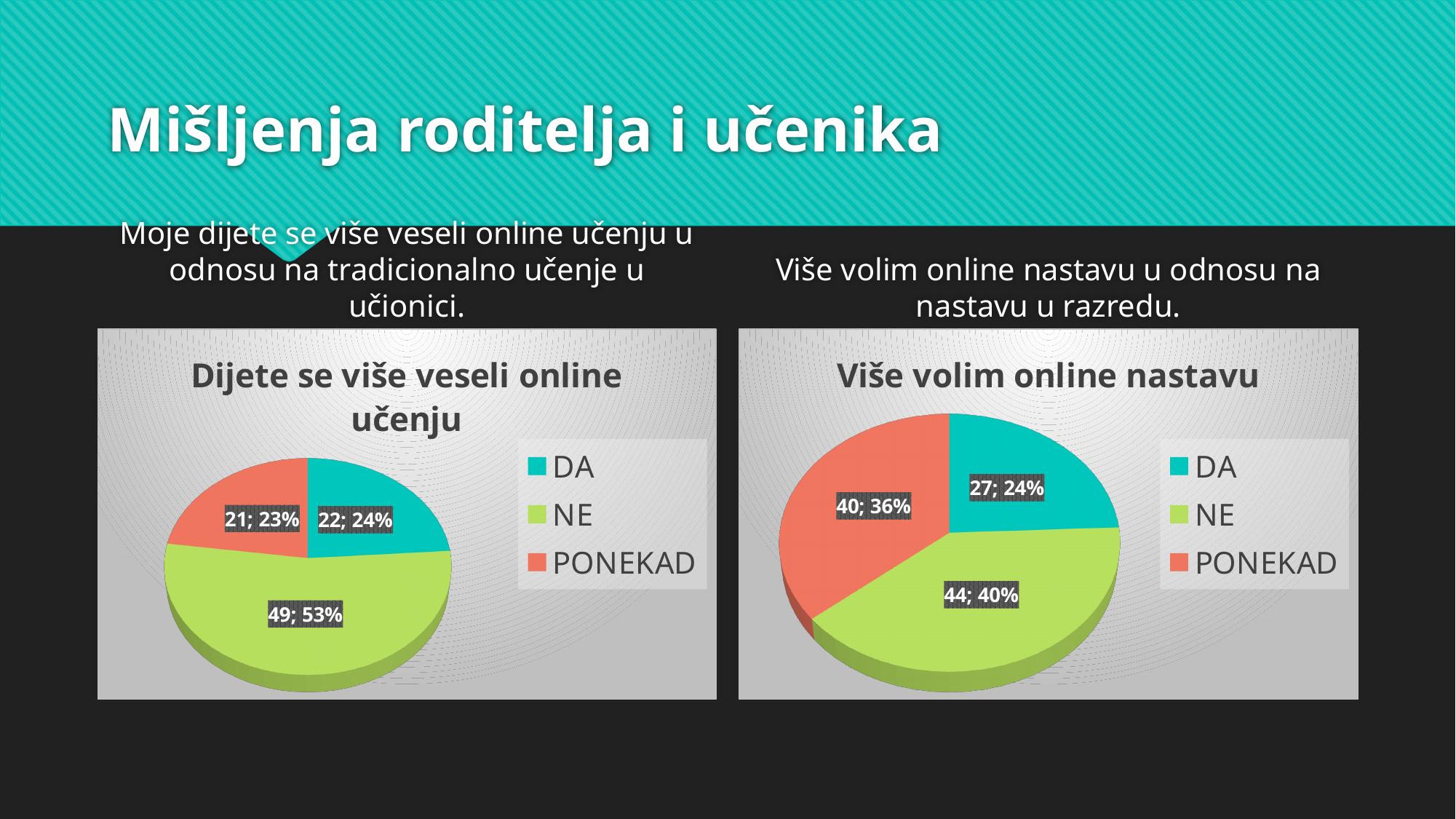
In the left chart 'Dijete se više veseli online učenju', what share of the pie does DA take? 24% In the left chart 'Dijete se više veseli online učenju', which is larger, DA or PONEKAD? DA In the right chart 'Više volim online nastavu', what share of the pie does NE take? 40% Which colour represents PONEKAD in the legend of the right chart 'Više volim online nastavu'? Red/orange In the left chart 'Dijete se više veseli online učenju', what is the total count across all slices? 92 What type of chart is the left chart 'Dijete se više veseli online učenju'? Pie chart In the right chart 'Više volim online nastavu', what is the difference between the counts for NE and DA? 17 In the right chart 'Više volim online nastavu', which category has the smallest slice? DA In the left chart 'Dijete se više veseli online učenju', what is the value for NE? 49; 53% In the right chart 'Više volim online nastavu', what is the value for PONEKAD? 40; 36% In the left chart 'Dijete se više veseli online učenju', which category has the largest slice? NE How many categories does the right chart 'Više volim online nastavu' show? 3